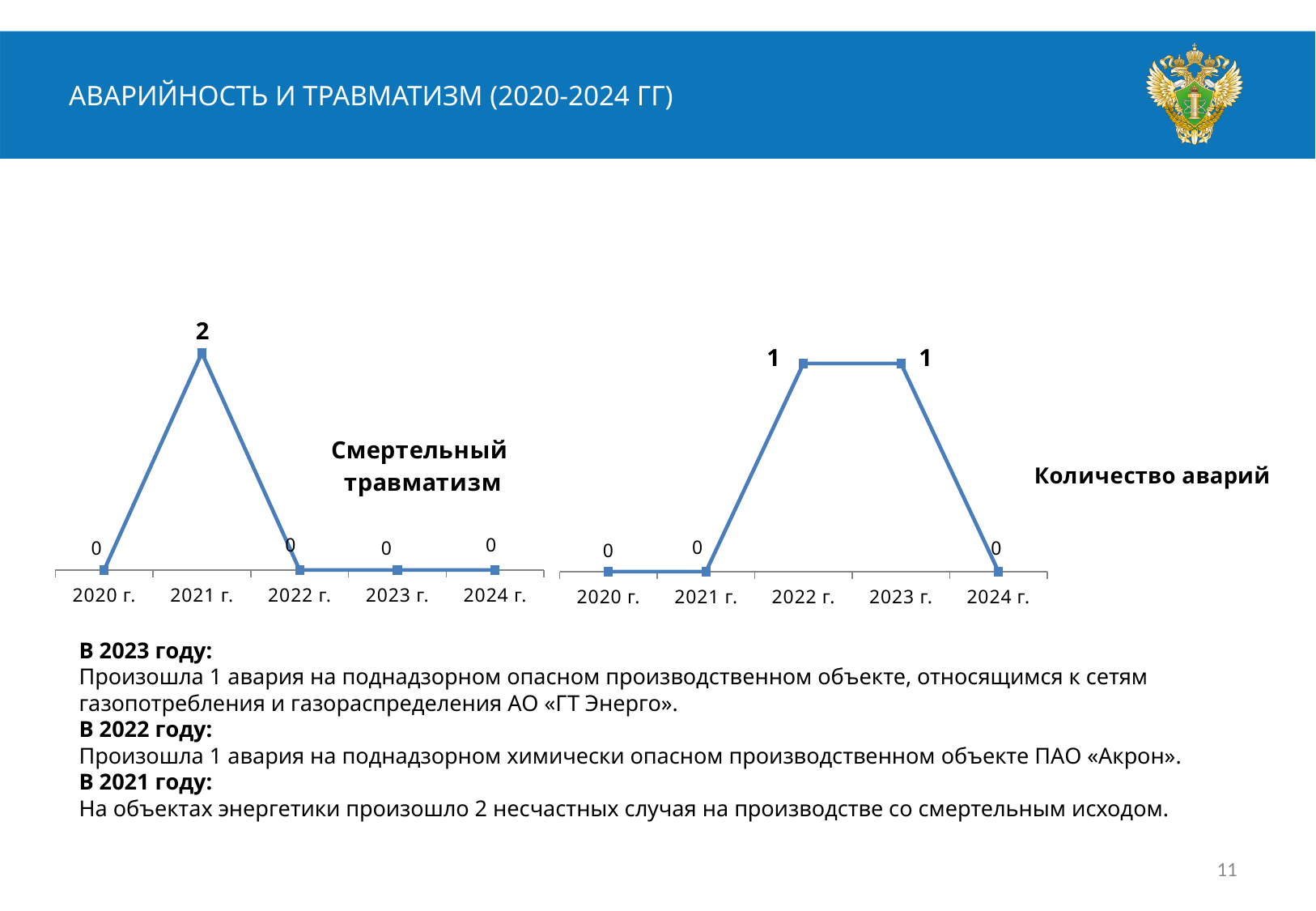
How many charts are shown on the slide? 2 In the 'Количество аварий' chart, does the value rise or fall from 2023 г. to 2024 г.? Fall Which is larger: the value for 2021 г. in the 'Смертельный травматизм' chart or the value for 2022 г. in the 'Количество аварий' chart? 2021 г. in the 'Смертельный травматизм' chart In the 'Количество аварий' chart, what is the value for 2024 г.? 0 In the 'Смертельный травматизм' chart, what is the value for 2023 г.? 0 In the 'Смертельный травматизм' chart, what is the difference between the values for 2021 г. and 2022 г.? 2 In the 'Смертельный травматизм' chart, what is the value for 2021 г.? 2 What kind of chart is the 'Смертельный травматизм' chart? Line chart How many years are plotted in the 'Количество аварий' chart? 5 In the 'Количество аварий' chart, what is the difference between the values for 2022 г. and 2021 г.? 1 In the 'Количество аварий' chart, what is the value for 2022 г.? 1 In the 'Смертельный травматизм' chart, which year has the highest value? 2021 г.